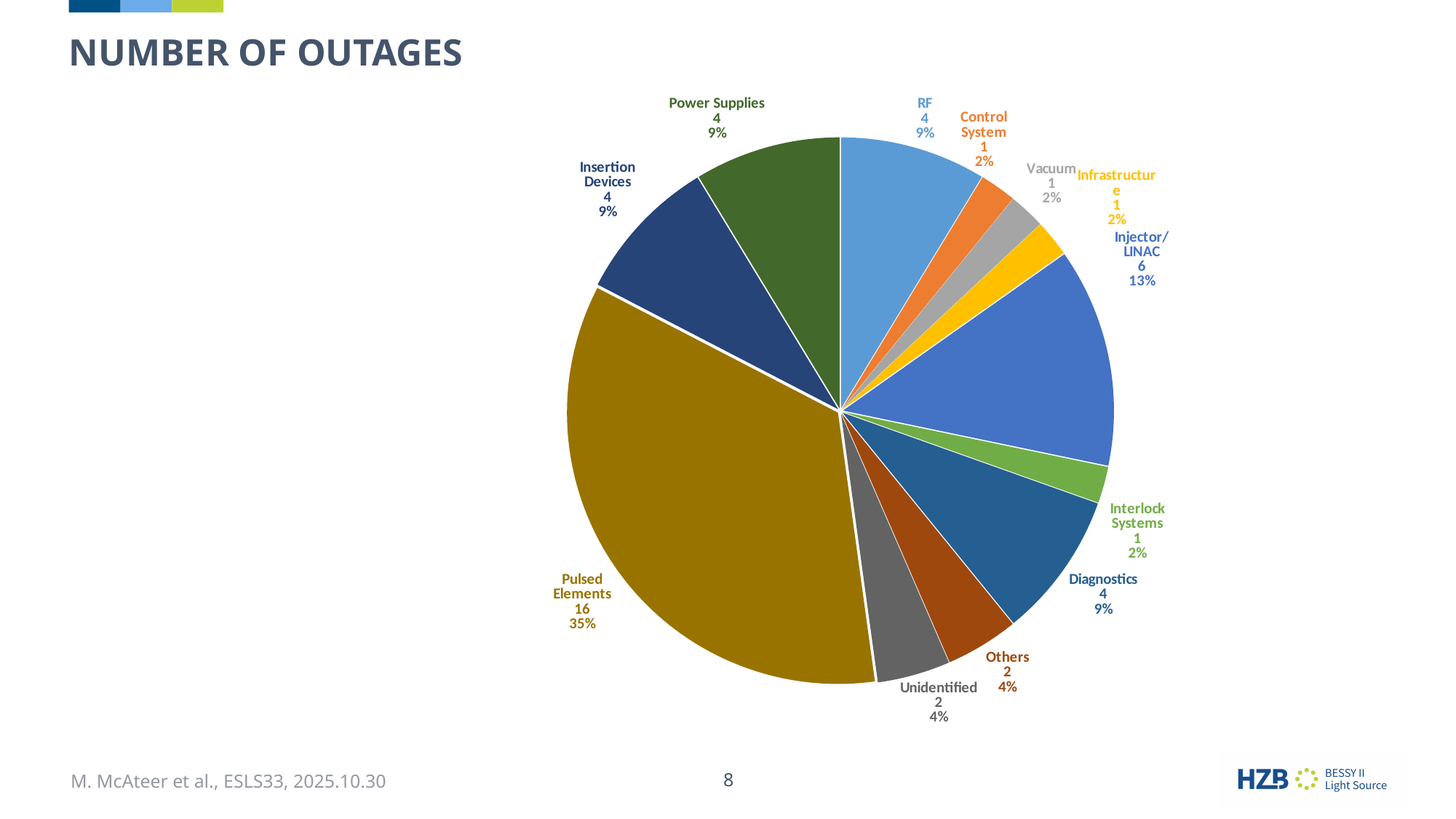
What is the total number of outages across all categories in the pie chart? 46 Which has more outages, Injector/LINAC or RF? Injector/LINAC What is the difference in the number of outages between Pulsed Elements and Injector/LINAC? 10 How many outages are attributed to Injector/LINAC? 6 What share of the pie does Pulsed Elements represent? 35% What percentage of outages is attributed to Diagnostics? 9% How many categories are shown in the pie chart? 12 How many outages are attributed to Unidentified causes? 2 What is the title of the chart? NUMBER OF OUTAGES What type of chart is shown on the slide? pie chart Which category has the largest number of outages? Pulsed Elements How many outages are attributed to Pulsed Elements? 16